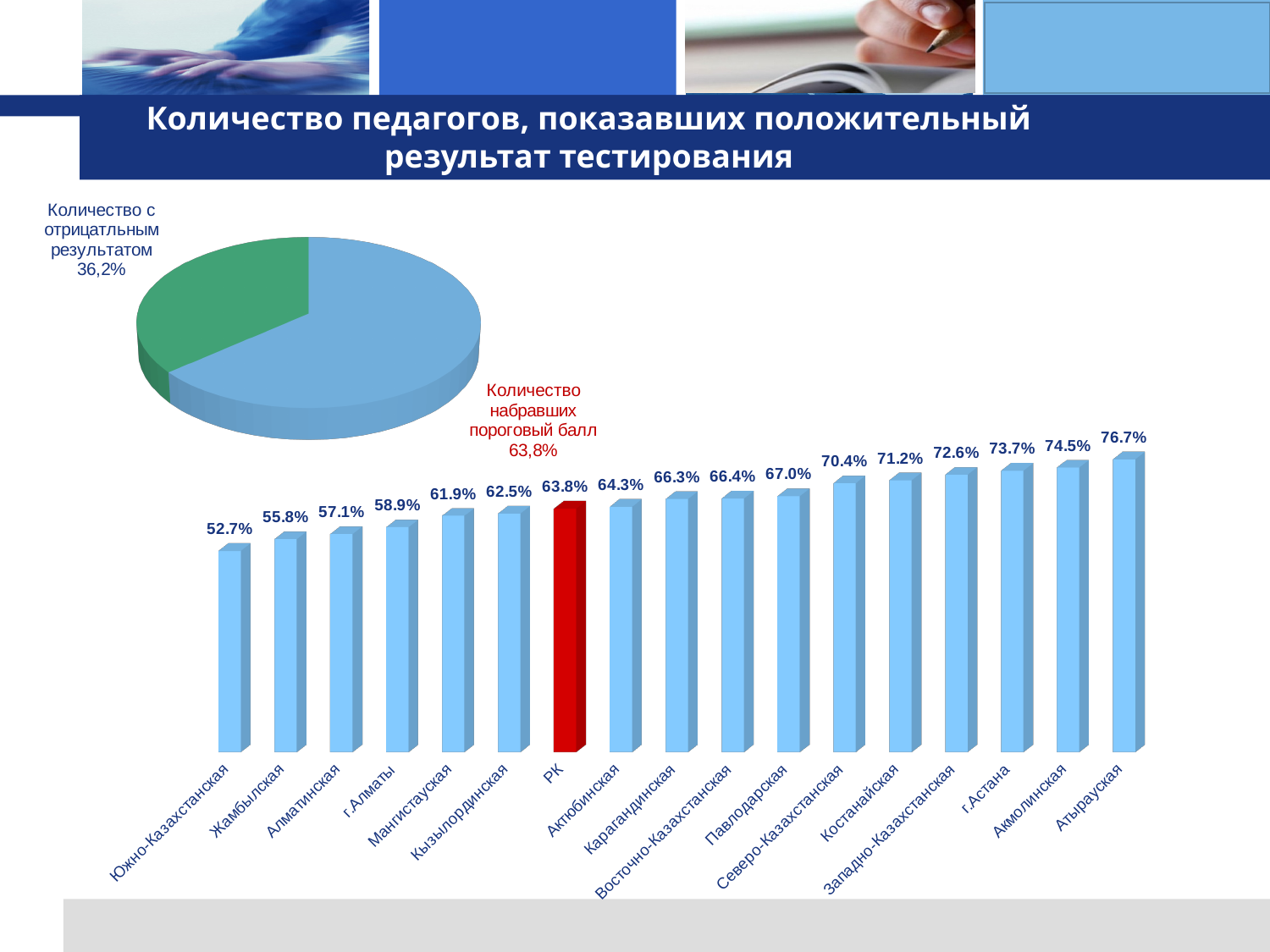
In the pie chart, what share is labelled 'Количество набравших пороговый балл'? 63,8% In the bar chart, what is the difference between the values for Атырауская and Южно-Казахстанская? 24.0% In the bar chart, which is larger: the value for г.Астана or the value for г.Алматы? г.Астана In the bar chart, what is the value for Атырауская? 76.7% What type of chart is the chart at the top left of the slide? pie chart How many bars are shown in the bar chart? 17 In the bar chart, do the values rise or fall from left to right? rise In the bar chart, which category has the lowest value? Южно-Казахстанская In the bar chart, which category has the highest value? Атырауская In the bar chart, what is the value for the red bar labelled РК? 63.8% In the bar chart, what is the value for Южно-Казахстанская? 52.7% In the pie chart, what share is labelled 'Количество с отрицатльным результатом'? 36,2%